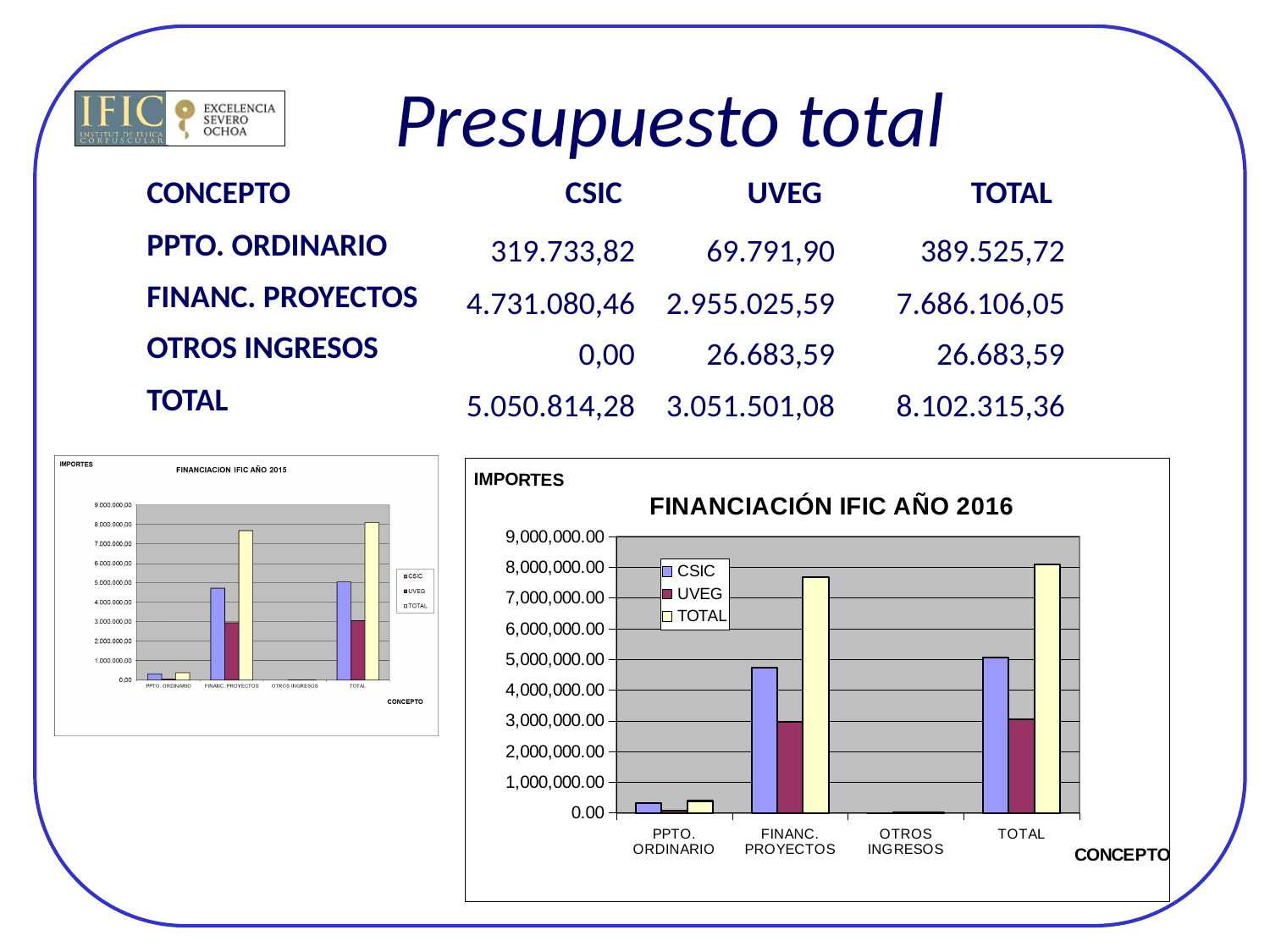
In the chart titled FINANCIACIÓN IFIC AÑO 2016, is the TOTAL value for the TOTAL category greater or less than 7,000,000.00? greater In the chart titled FINANCIACIÓN IFIC AÑO 2016, is the UVEG value for FINANC. PROYECTOS greater or less than 2,000,000.00? greater In the chart titled FINANCIACIÓN IFIC AÑO 2016, which category has the tallest TOTAL bar? TOTAL In the chart titled FINANCIACIÓN IFIC AÑO 2016, which category has the lowest CSIC bar? OTROS INGRESOS What is the title of the smaller chart on the left of the slide? FINANCIACION IFIC AÑO 2015 In the chart titled FINANCIACIÓN IFIC AÑO 2016, what label is shown on the x axis? CONCEPTO In the chart titled FINANCIACIÓN IFIC AÑO 2016, how many categories are shown on the x axis? 4 What kind of chart is the chart titled FINANCIACIÓN IFIC AÑO 2016? Bar chart In the chart titled FINANCIACIÓN IFIC AÑO 2016, is the CSIC value for FINANC. PROYECTOS greater or less than 4,000,000.00? greater In the chart titled FINANCIACIÓN IFIC AÑO 2016, how many series does the legend list? 3 In the chart titled FINANCIACIÓN IFIC AÑO 2016, which is larger for FINANC. PROYECTOS, the CSIC bar or the UVEG bar? CSIC